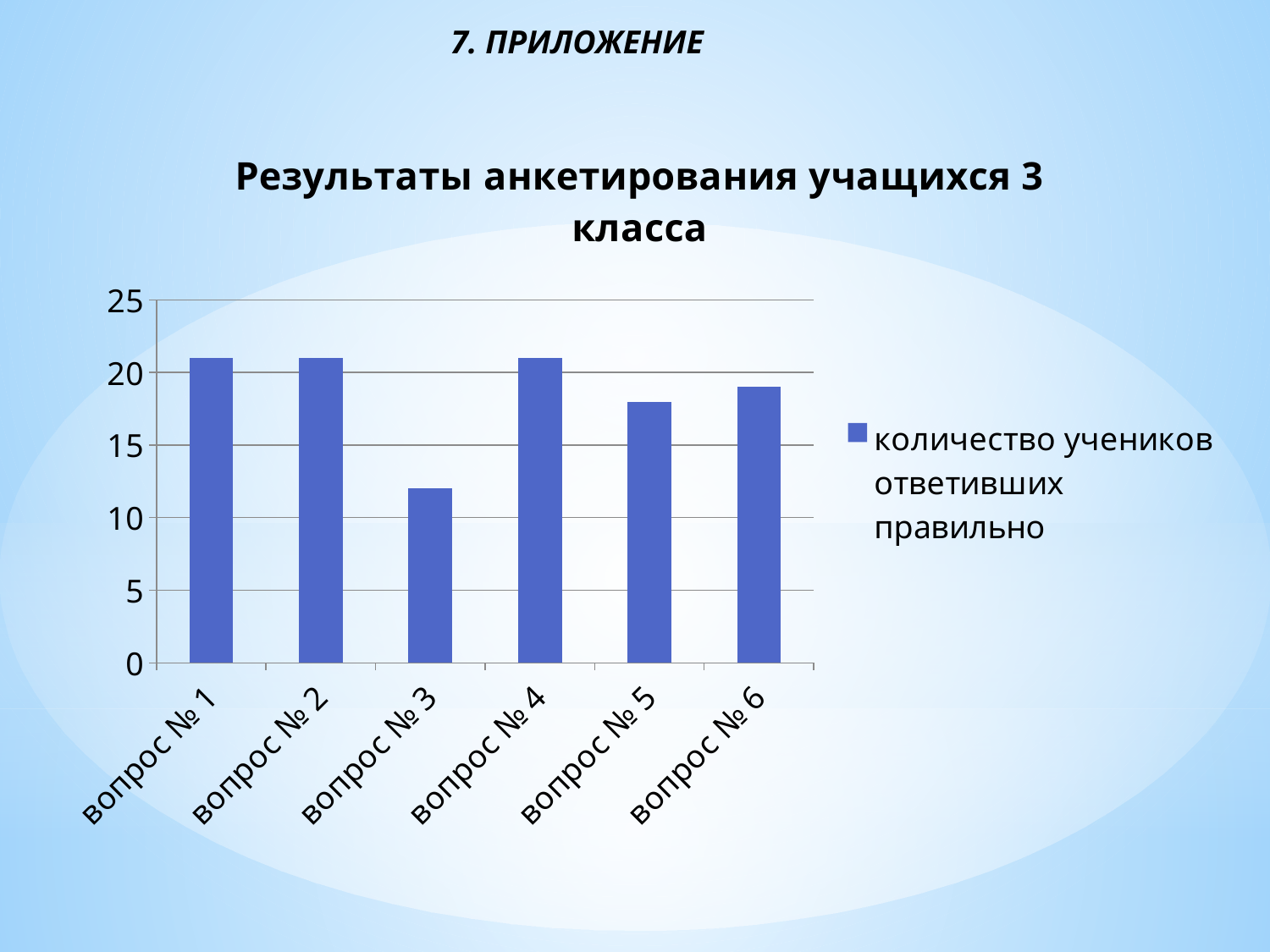
How many categories (questions) are shown on the x axis of the chart? 6 Which is larger, the value for вопрос № 4 or the value for вопрос № 5? вопрос № 4 What series name is shown in the chart's legend? количество учеников ответивших правильно Is the value for вопрос № 1 greater or less than 20? greater Is the value for вопрос № 3 greater or less than 10? greater Is the value for вопрос № 5 greater or less than 15? greater What is the title of the chart? Результаты анкетирования учащихся 3 класса Which question has the lowest number of students who answered correctly? вопрос № 3 Which is larger, the value for вопрос № 1 or the value for вопрос № 3? вопрос № 1 What kind of chart is shown on the slide? bar chart How many series does the chart's legend list? 1